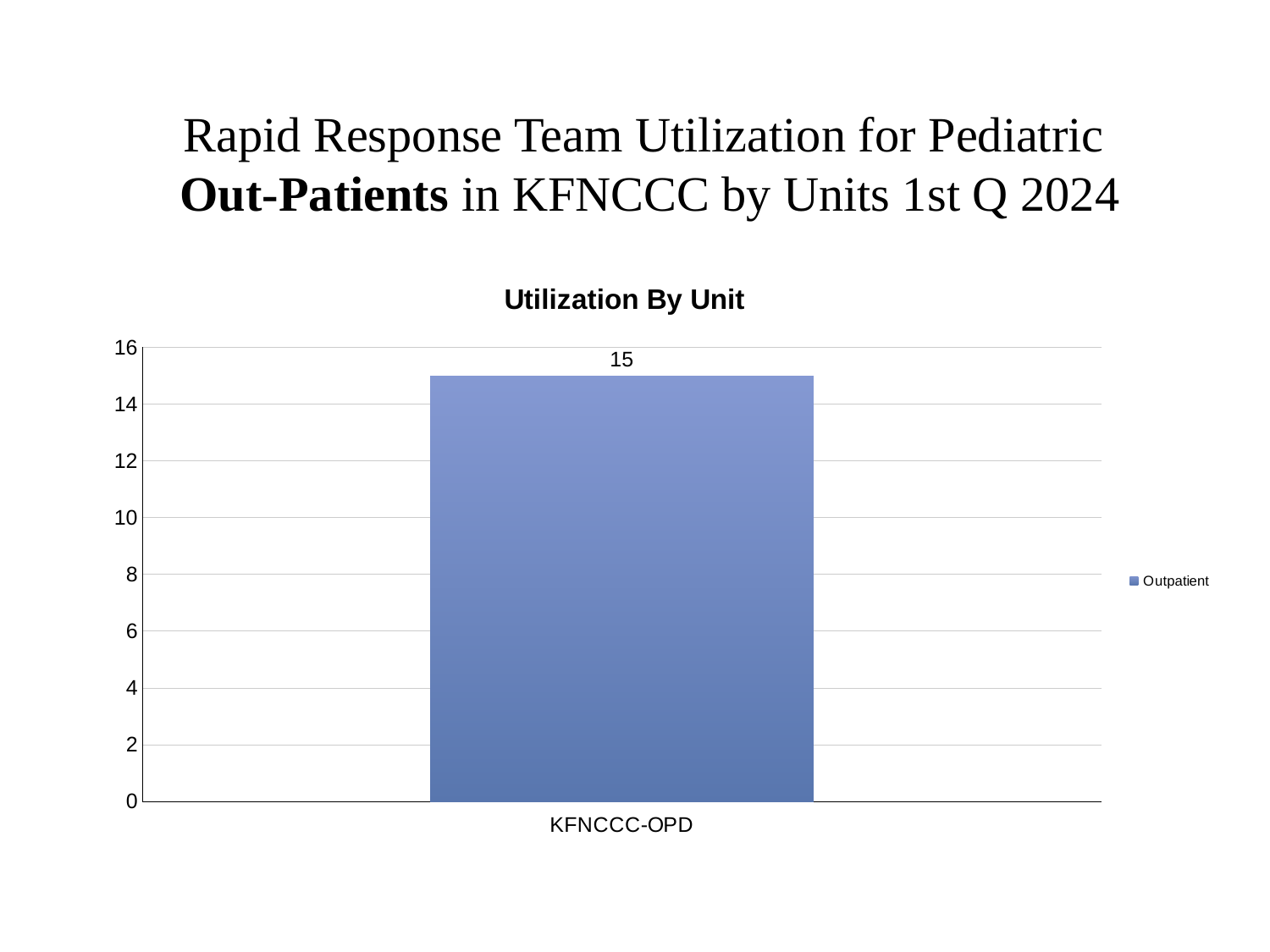
What is the title of the chart? Utilization By Unit Is the value for KFNCCC-OPD greater or less than 10? greater What is the maximum value shown on the y axis? 16 What kind of chart is shown on the slide? bar chart What series name is shown in the legend? Outpatient What is the value for KFNCCC-OPD? 15 Is the value for KFNCCC-OPD greater or less than 16? less How many categories are plotted on the x axis? 1 How many series does the legend list? 1